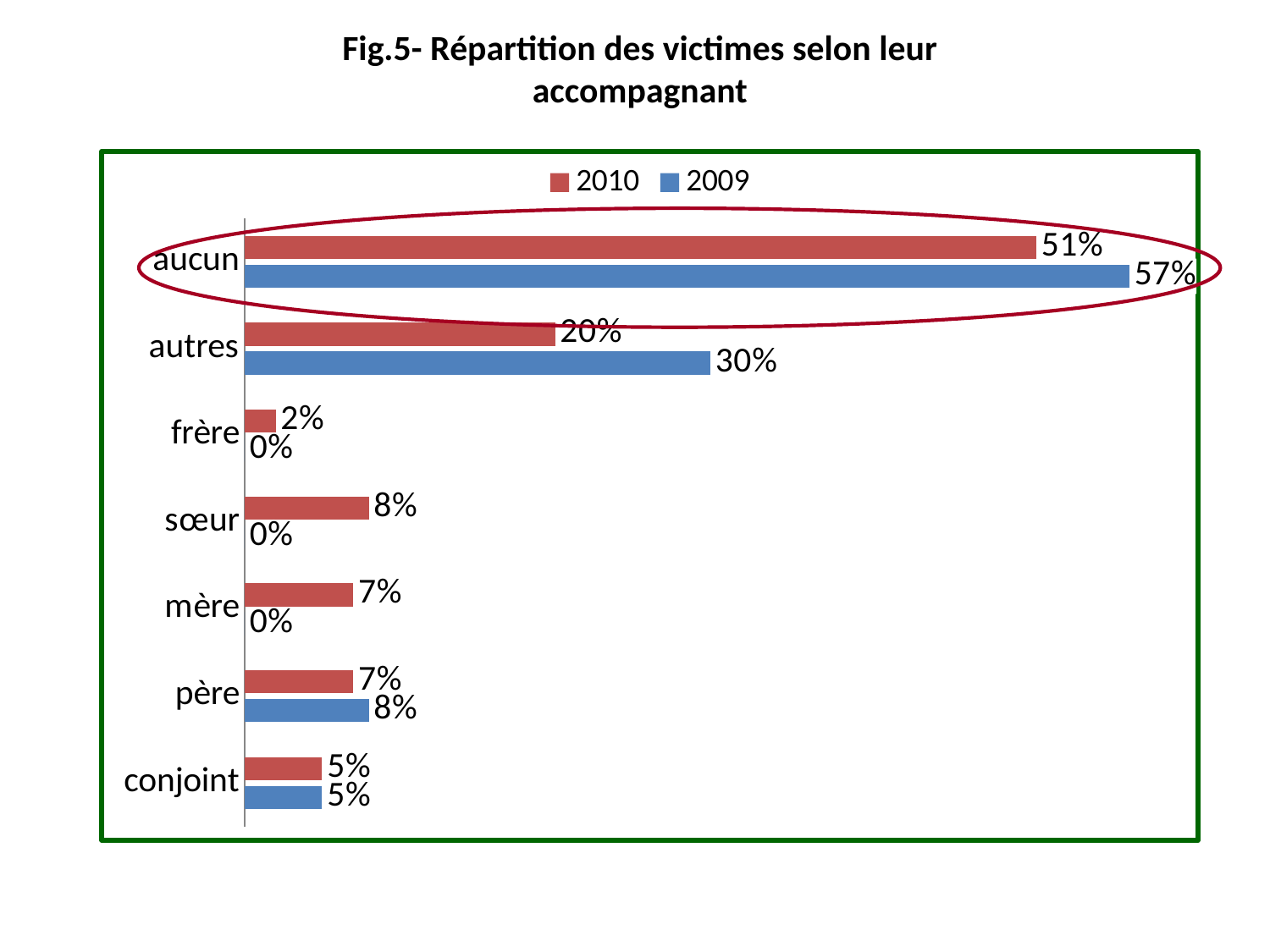
What is the value for "sœur" in 2010? 8% Which category has the lowest value in 2010? frère What is the difference between the 2009 and 2010 values for "autres"? 10% How many series does the legend list? 2 What is the difference between the 2009 and 2010 values for "aucun"? 6% What is the value for "aucun" in 2009? 57% How many categories are shown on the chart? 7 Which is larger for "père": the 2010 value or the 2009 value? 2009 Which category has the highest value in 2010? aucun What is the value for "autres" in 2010? 20% What is the value for "père" in 2009? 8% What kind of chart is shown on the slide? bar chart